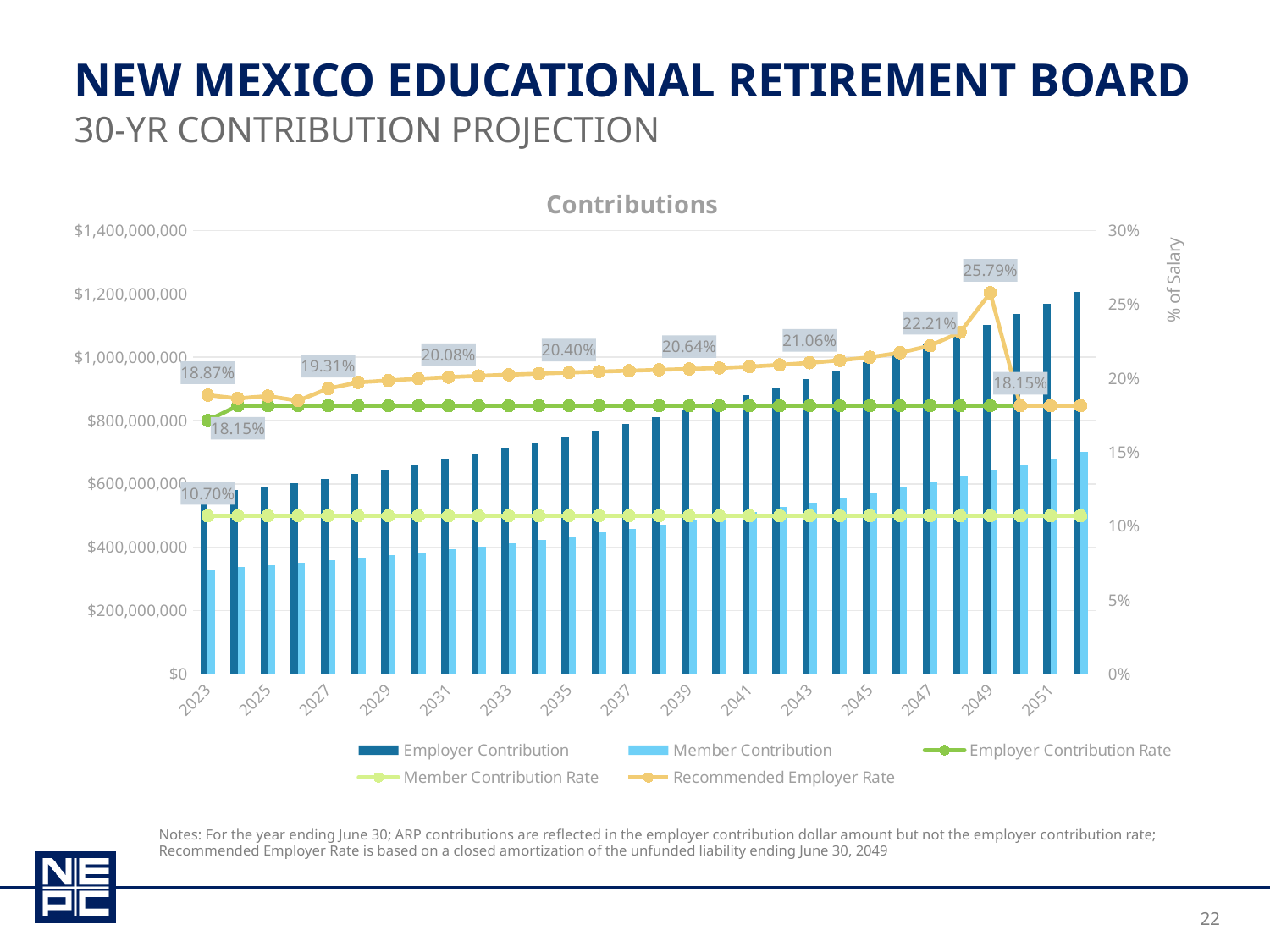
Is the Employer Contribution for 2023 greater or less than $600,000,000? less Is the Member Contribution for 2023 greater or less than $400,000,000? less Do the Employer Contribution bars generally rise or fall from 2023 to 2052? rise Is the Employer Contribution for the final year (2052) greater or less than $1,000,000,000? greater How many series does the chart legend list? 5 What is the Recommended Employer Rate labeled for 2023? 18.87% What is the labeled Member Contribution Rate? 10.70% Which is larger in 2023, the Employer Contribution or the Member Contribution? Employer Contribution What is the highest labeled value of the Recommended Employer Rate line? 25.79% What is the title of the chart? Contributions What is the labeled Employer Contribution Rate shown near the end of the projection? 18.15% What kind of chart is shown on the slide? Combination bar and line chart